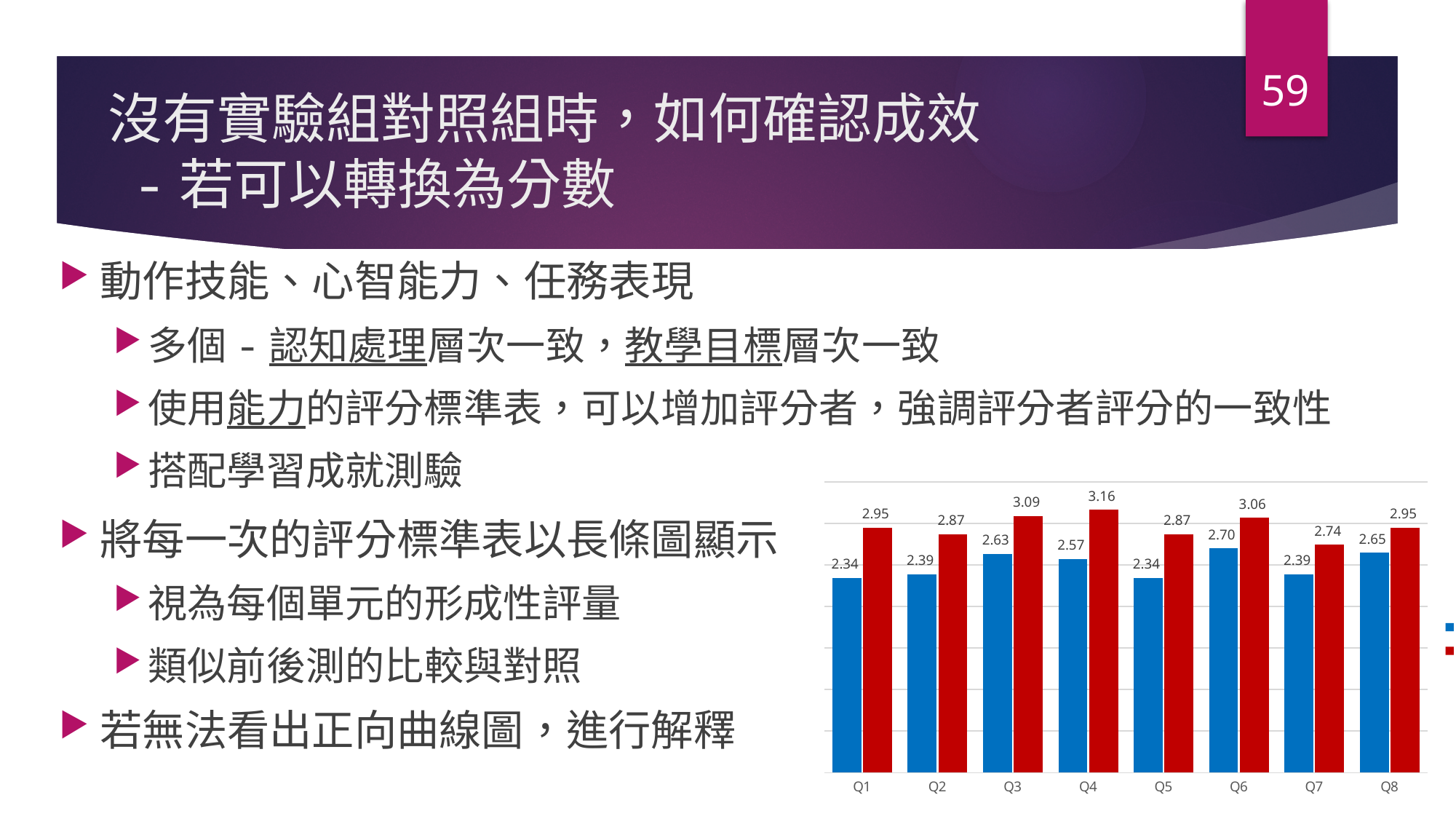
What is the value of the red bar for Q2? 2.87 How many series does the legend list? 2 For which category is the blue bar highest? Q6 What is the value of the blue bar for Q1? 2.34 What is the value of the blue bar for Q7? 2.39 What is the difference between the red and blue bars for Q4? 0.59 For which category is the red bar lowest? Q7 Which is larger, the blue bar for Q3 or the blue bar for Q4? Q3 What kind of chart is shown on the slide? bar chart How many categories are shown on the x axis? 8 For which category is the red bar highest? Q4 What is the value of the red bar for Q4? 3.16